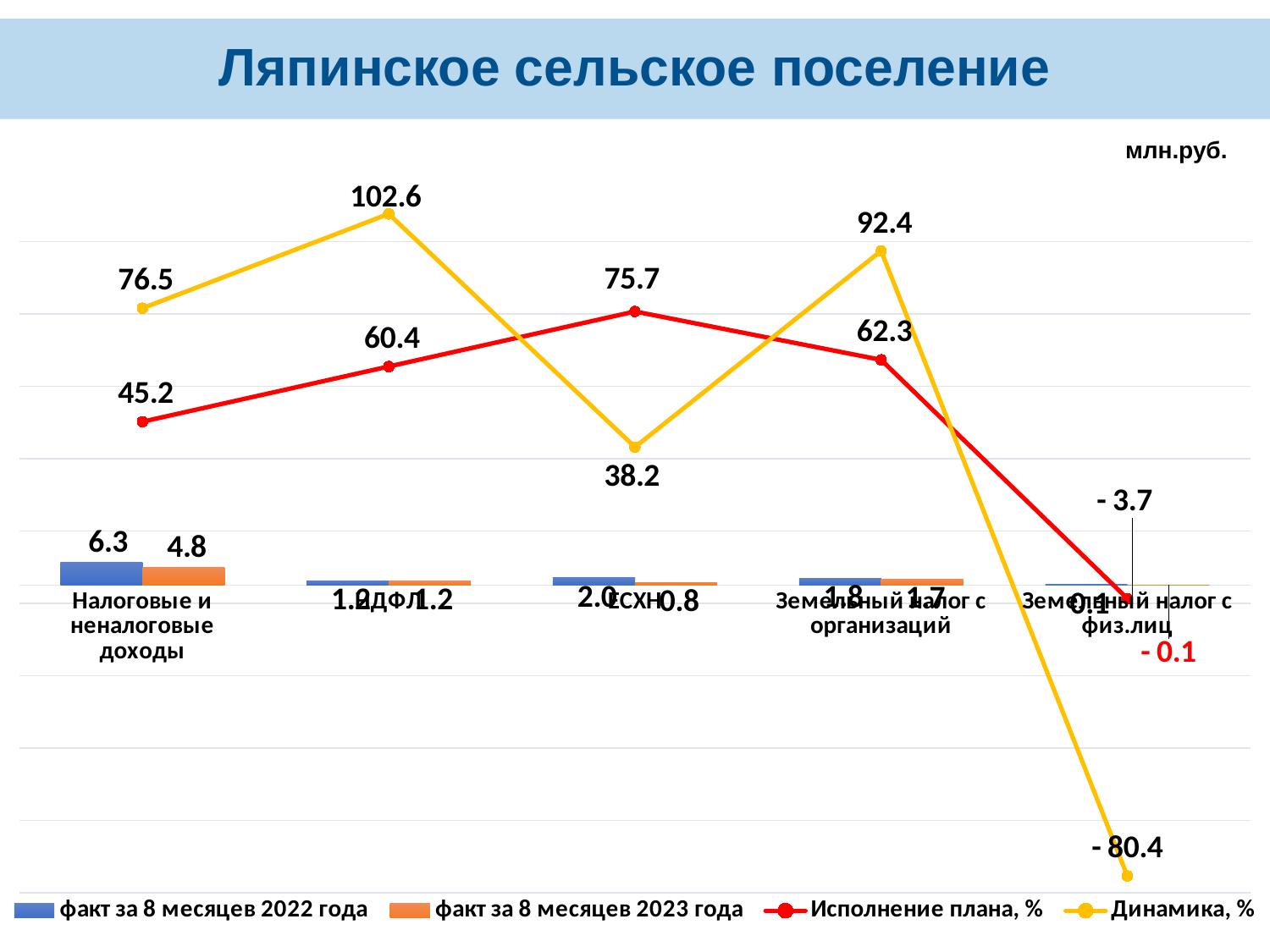
What is the value of 'Динамика, %' for НДФЛ? 102.6 What is the value of 'Исполнение плана, %' for ЕСХН? 75.7 What is the value of 'Динамика, %' for 'Земельный налог с физ.лиц'? -80.4 Which category has the lowest value of 'Исполнение плана, %'? Земельный налог с физ.лиц Which category has the highest value of 'Динамика, %'? НДФЛ What is the value of 'факт за 8 месяцев 2022 года' for 'Налоговые и неналоговые доходы'? 6.3 What is the difference between 'факт за 8 месяцев 2022 года' and 'факт за 8 месяцев 2023 года' for 'Налоговые и неналоговые доходы'? 1.5 How many categories are shown on the x axis? 5 How many series does the legend list? 4 What is the value of 'факт за 8 месяцев 2023 года' for 'Земельный налог с организаций'? 1.7 Which is larger for 'Земельный налог с организаций': 'Исполнение плана, %' or 'Динамика, %'? Динамика, % What kind of chart is this? Combined bar and line chart